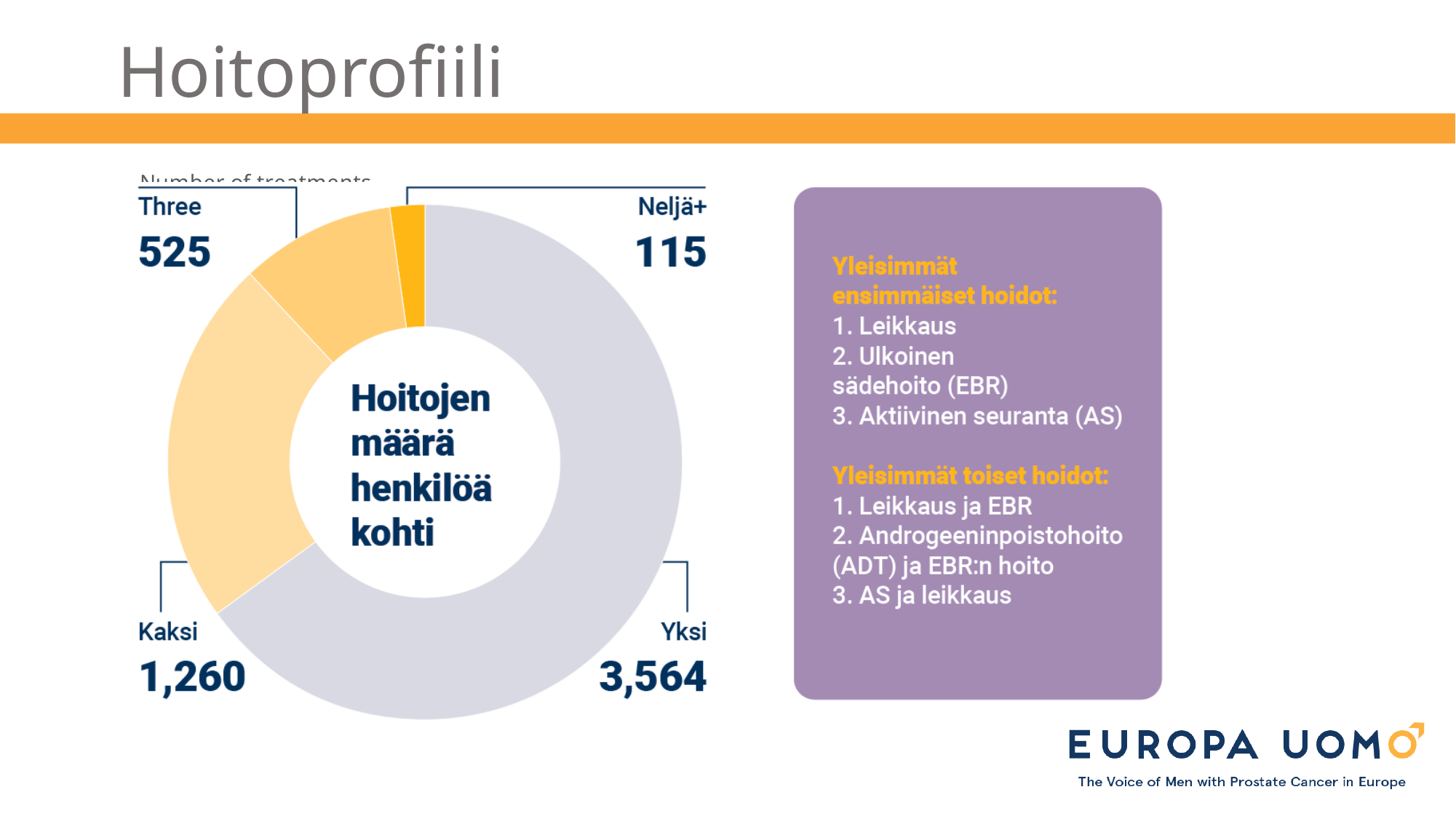
What is the difference between the values for Yksi and Kaksi? 2,304 How many categories does the donut chart show? 4 What is the value for Neljä+ in the donut chart? 115 What is the difference between the values for Three and Neljä+? 410 Which is larger, the value for Kaksi or the value for Three? Kaksi What kind of chart is shown on the slide? Pie chart (donut) Which category has the largest value in the donut chart? Yksi What is the value for Three in the donut chart? 525 Which category has the smallest value in the donut chart? Neljä+ What text is written in the centre of the donut chart? Hoitojen määrä henkilöä kohti What is the value for Kaksi in the donut chart? 1,260 What is the value for Yksi in the donut chart? 3,564